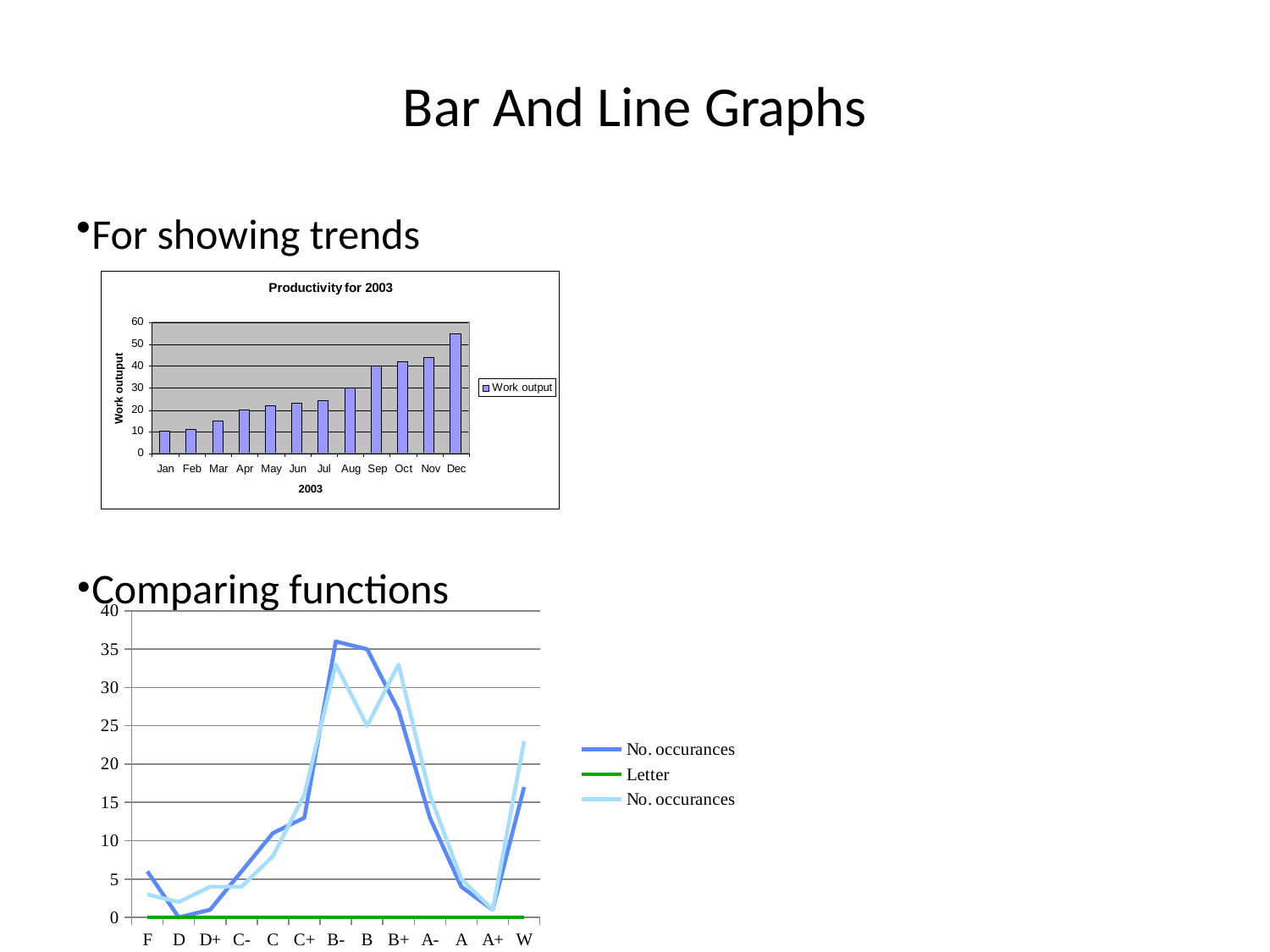
In the 'Productivity for 2003' chart, is the value for Jan greater or less than 20? less In the 'Productivity for 2003' chart, which month has the highest work output? Dec In the 'Productivity for 2003' chart, do the values rise or fall from Jan to Dec? rise In the 'Productivity for 2003' chart, is the value for Sep greater or less than 30? greater How many months are shown on the x axis of the 'Productivity for 2003' chart? 12 How many categories are shown on the x axis of the bottom chart? 13 How many series does the legend of the 'Productivity for 2003' chart list? 1 In the bottom chart, at category B, which series is larger: the dark blue 'No. occurances' line or the light blue 'No. occurances' line? the dark blue 'No. occurances' line How many series does the legend of the bottom chart list? 3 What type of chart is the bottom chart on the slide? line chart In the 'Productivity for 2003' chart, is the value for Dec greater or less than 50? greater What type of chart is the 'Productivity for 2003' chart? bar chart